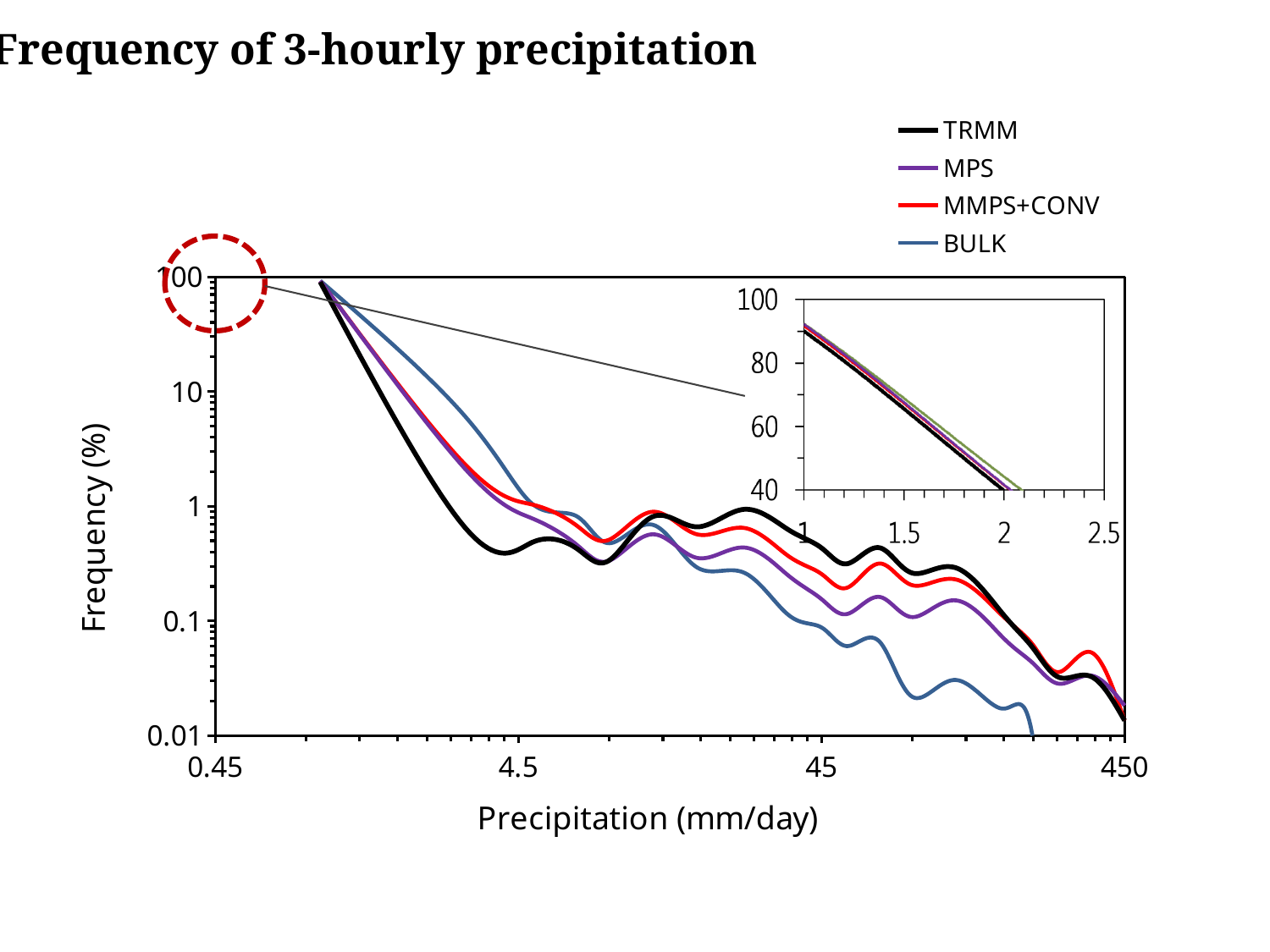
What kind of chart is shown on the slide? line chart Which series are listed in the legend? TRMM, MPS, MMPS+CONV, BULK At 45 mm/day, which series has the higher frequency, TRMM or BULK? TRMM Which series has the lowest frequency at 45 mm/day? BULK What is the label of the y axis? Frequency (%) At 45 mm/day, which series has the higher frequency, MMPS+CONV or MPS? MMPS+CONV Is the TRMM frequency at 4.5 mm/day greater or less than 1? less How many series does the legend list? 4 In the inset chart, is the TRMM frequency at 1 mm/day greater or less than 80? greater Overall, does frequency rise or fall as precipitation increases along the x axis? fall Which series has the lowest frequency at 4.5 mm/day? TRMM Is the TRMM frequency at 45 mm/day greater or less than 1? less